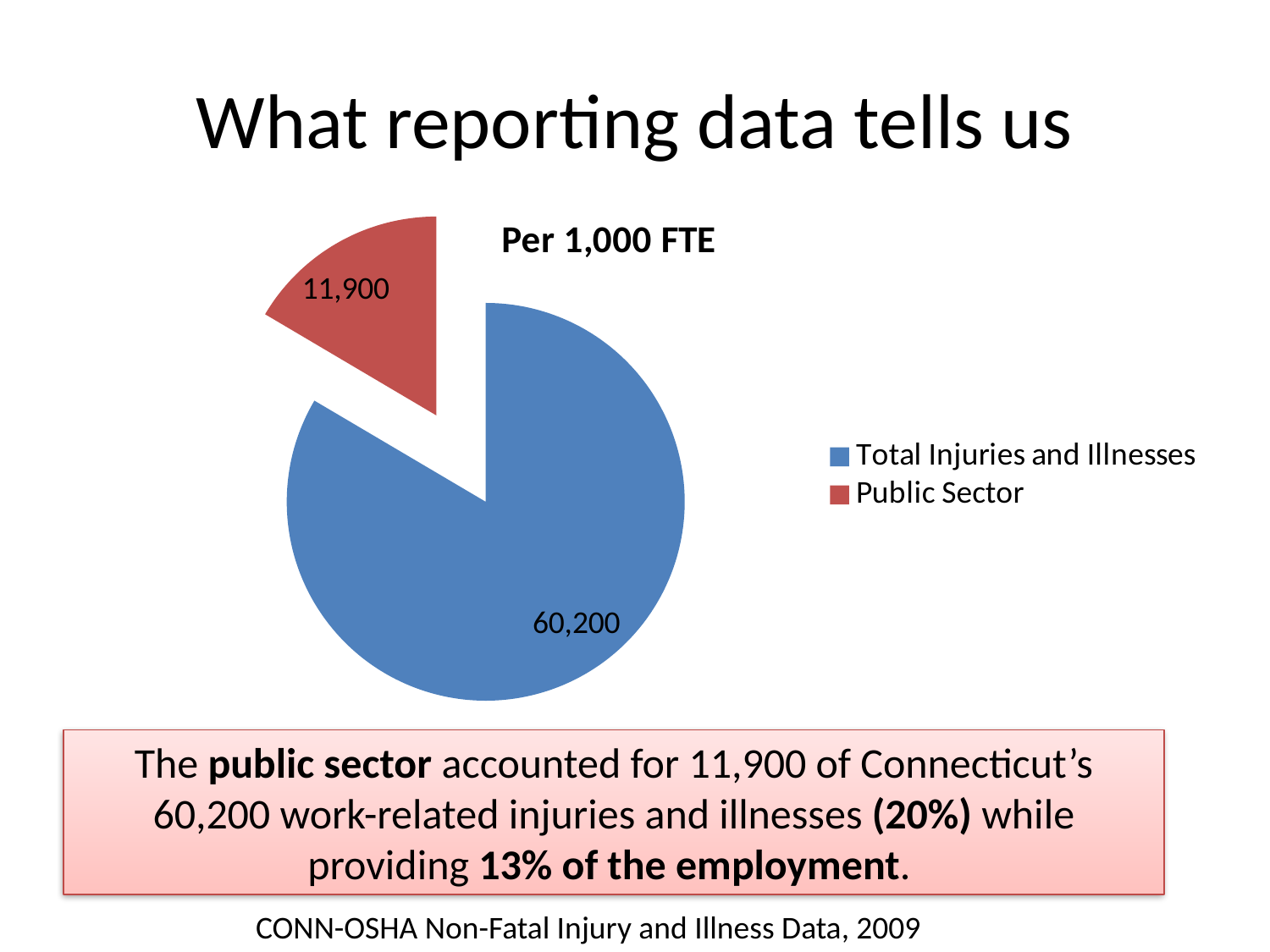
What value is shown for the Public Sector slice? 11,900 Which slice of the pie is the largest? Total Injuries and Illnesses How many slices does the pie chart have? 2 What colour is the Public Sector slice? red What is the difference between the Total Injuries and Illnesses value and the Public Sector value? 48,300 How many entries does the legend list? 2 What type of chart is shown on the slide? pie chart What is the title of the chart? Per 1,000 FTE Which is larger, the Public Sector slice or the Total Injuries and Illnesses slice? Total Injuries and Illnesses What value is shown for the Total Injuries and Illnesses slice? 60,200 Which slice of the pie is the smallest? Public Sector